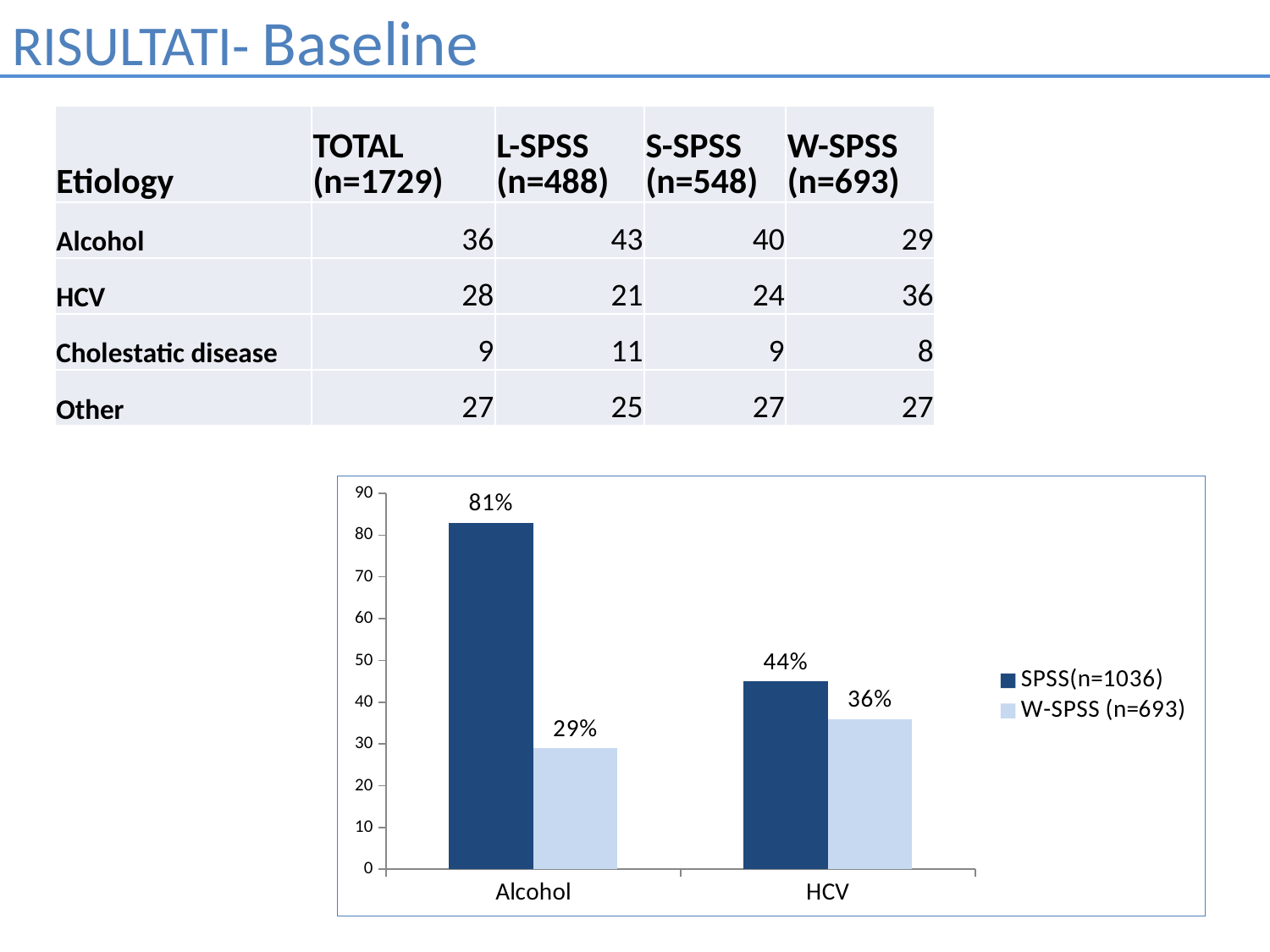
What kind of chart is shown on the slide? Bar chart Which category has the highest value for the SPSS(n=1036) series? Alcohol How many series does the chart legend list? 2 What is the value for W-SPSS (n=693) in the HCV category? 36% Which category has the lowest value for the W-SPSS (n=693) series? Alcohol How many categories are shown on the x axis of the chart? 2 What is the value for W-SPSS (n=693) in the Alcohol category? 29% What is the difference between the SPSS(n=1036) and W-SPSS (n=693) values for Alcohol? 52% What is the value for SPSS(n=1036) in the Alcohol category? 81% Which is larger for HCV: the SPSS(n=1036) value or the W-SPSS (n=693) value? SPSS(n=1036) What is the value for SPSS(n=1036) in the HCV category? 44% What is the difference between the SPSS(n=1036) and W-SPSS (n=693) values for HCV? 8%